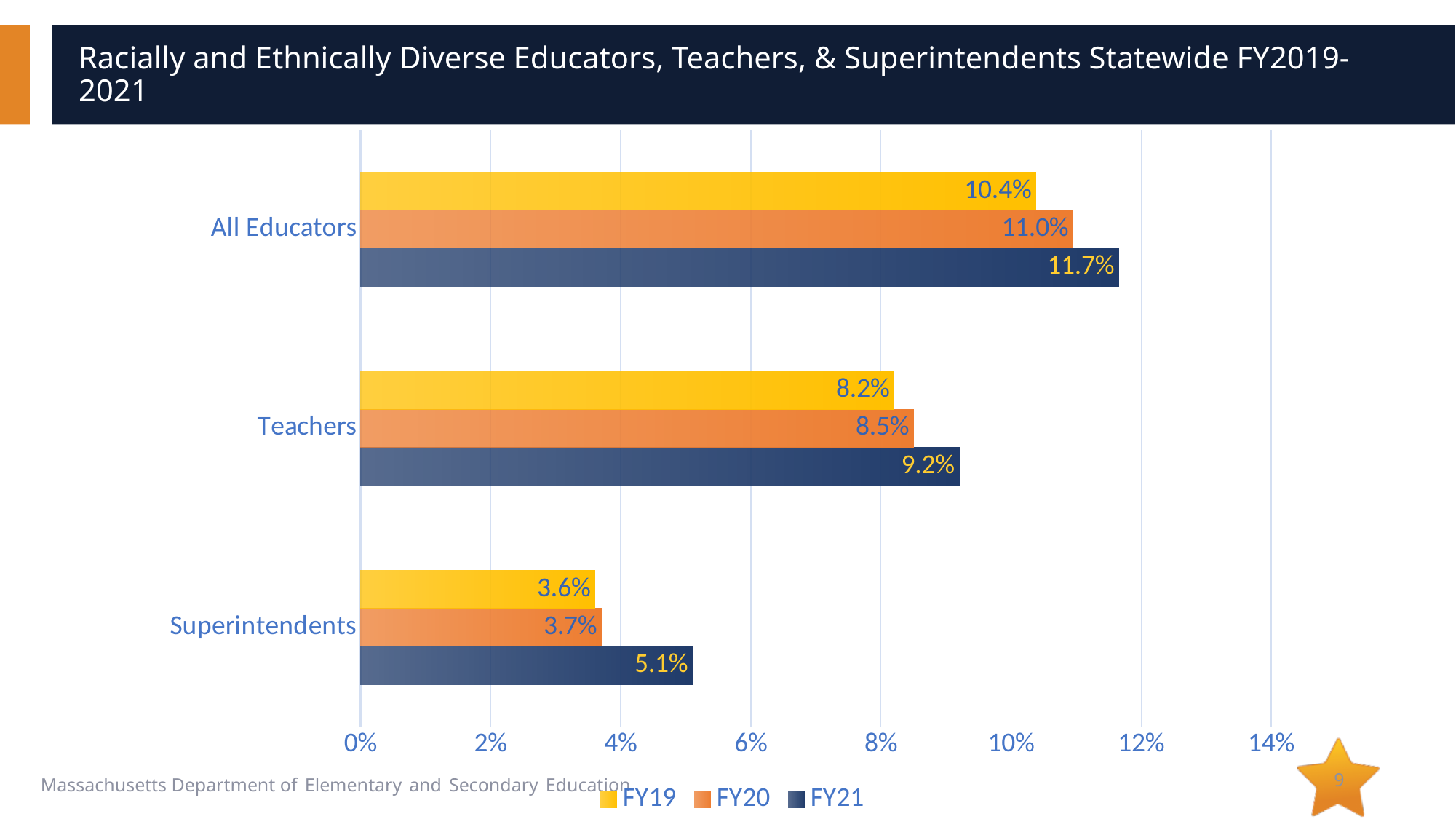
What is the difference between the FY21 values for All Educators and Teachers? 2.5% Is the FY21 value for Teachers greater or less than 10%? less What is the FY19 value for Superintendents? 3.6% What kind of chart is shown on the slide? Bar chart Which category has the highest FY21 value? All Educators Which category has the lowest FY19 value? Superintendents What is the difference between the FY21 and FY19 values for Superintendents? 1.5% How many categories are shown on the chart? 3 How many series does the legend list? 3 Which is larger, the FY20 value for Teachers or the FY19 value for All Educators? FY19 value for All Educators What is the FY21 value for All Educators? 11.7% What is the FY20 value for Teachers? 8.5%